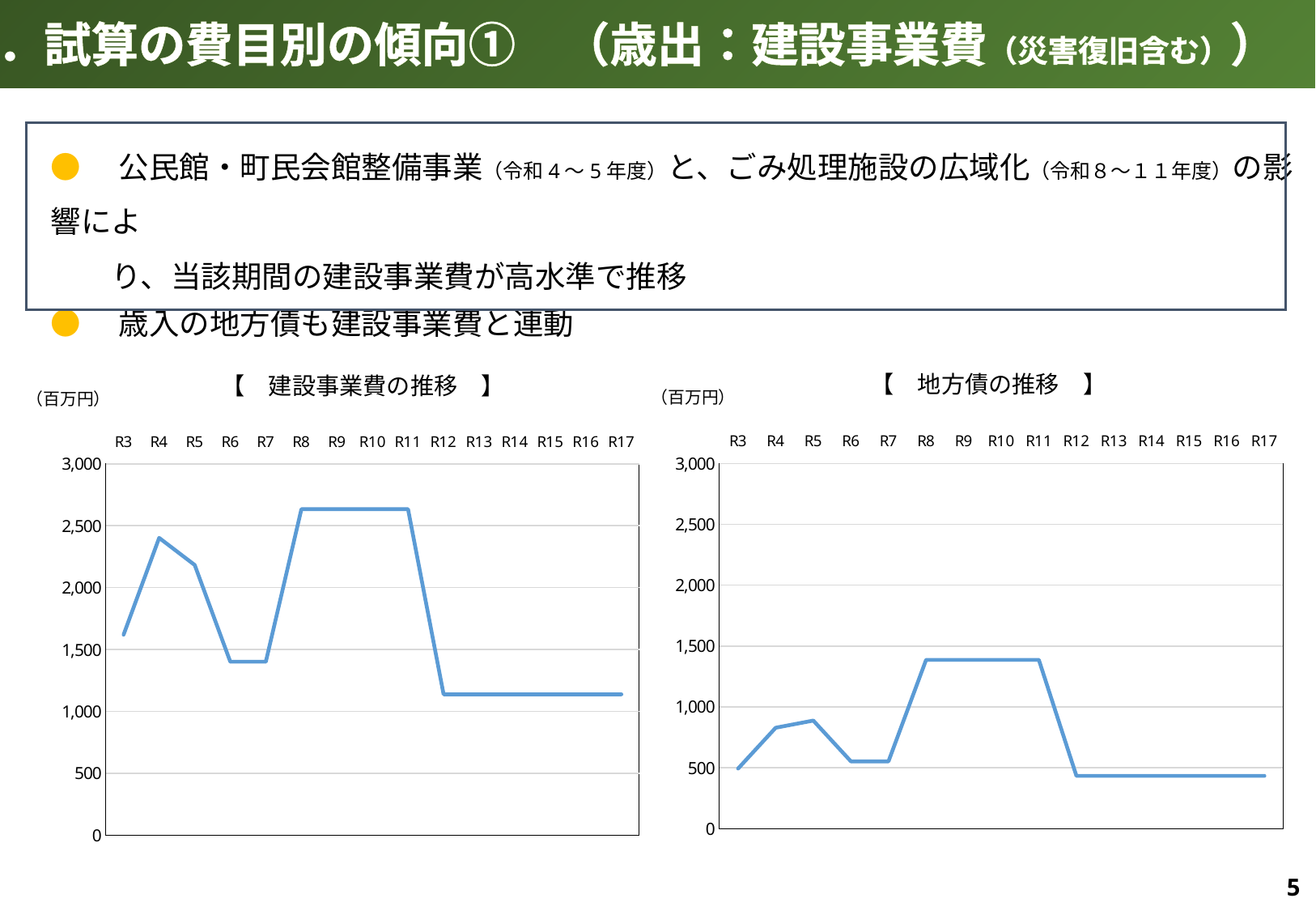
How many fiscal years are plotted on the x axis of the 地方債の推移 chart on the right? 15 In the 地方債の推移 chart on the right, is the value for R13 greater or less than 500? less In the 建設事業費の推移 chart on the left, which is larger, the value for R4 or the value for R6? R4 In the 建設事業費の推移 chart on the left, does the value rise or fall from R11 to R12? fall In the 地方債の推移 chart on the right, which is larger, the value for R5 or the value for R7? R5 What unit is shown above the y axis of the 地方債の推移 chart on the right? 百万円 In the 建設事業費の推移 chart on the left, is the value for R14 greater or less than 1,000? greater In the 建設事業費の推移 chart on the left, is the value for R6 greater or less than 1,500? less In the 地方債の推移 chart on the right, does the value rise or fall from R7 to R8? rise What kind of chart is the 建設事業費の推移 chart on the left? line chart